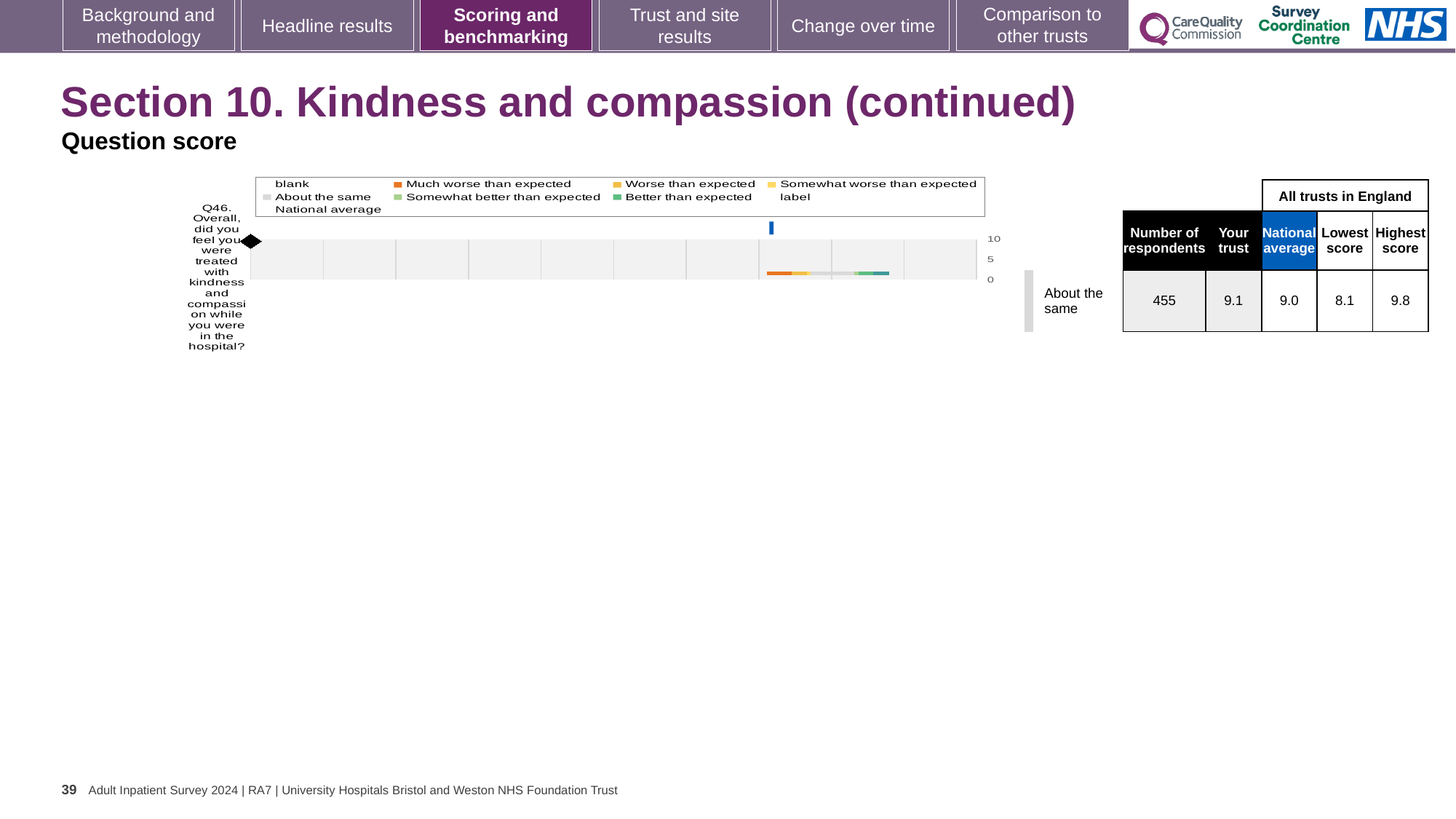
Which question is plotted on the chart? Q46. Overall, did you feel you were treated with kindness and compassion while you were in the hospital? According to the table beside the chart, what is the national average score for Q46? 9.0 Is the trust's score for Q46 higher or lower than the national average? higher What benchmarking category is the trust's Q46 score placed in? About the same According to the table beside the chart, what is the highest score among all trusts in England for Q46? 9.8 How many questions are plotted on the chart? 1 What is the difference between the highest and lowest scores among all trusts in England for Q46? 1.7 How many respondents answered Q46, according to the table beside the chart? 455 According to the table beside the chart, what is the lowest score among all trusts in England for Q46? 8.1 What kind of chart is shown on the slide? bar chart According to the table beside the chart, what is the 'Your trust' score for Q46? 9.1 What is the highest value shown on the chart's axis? 10